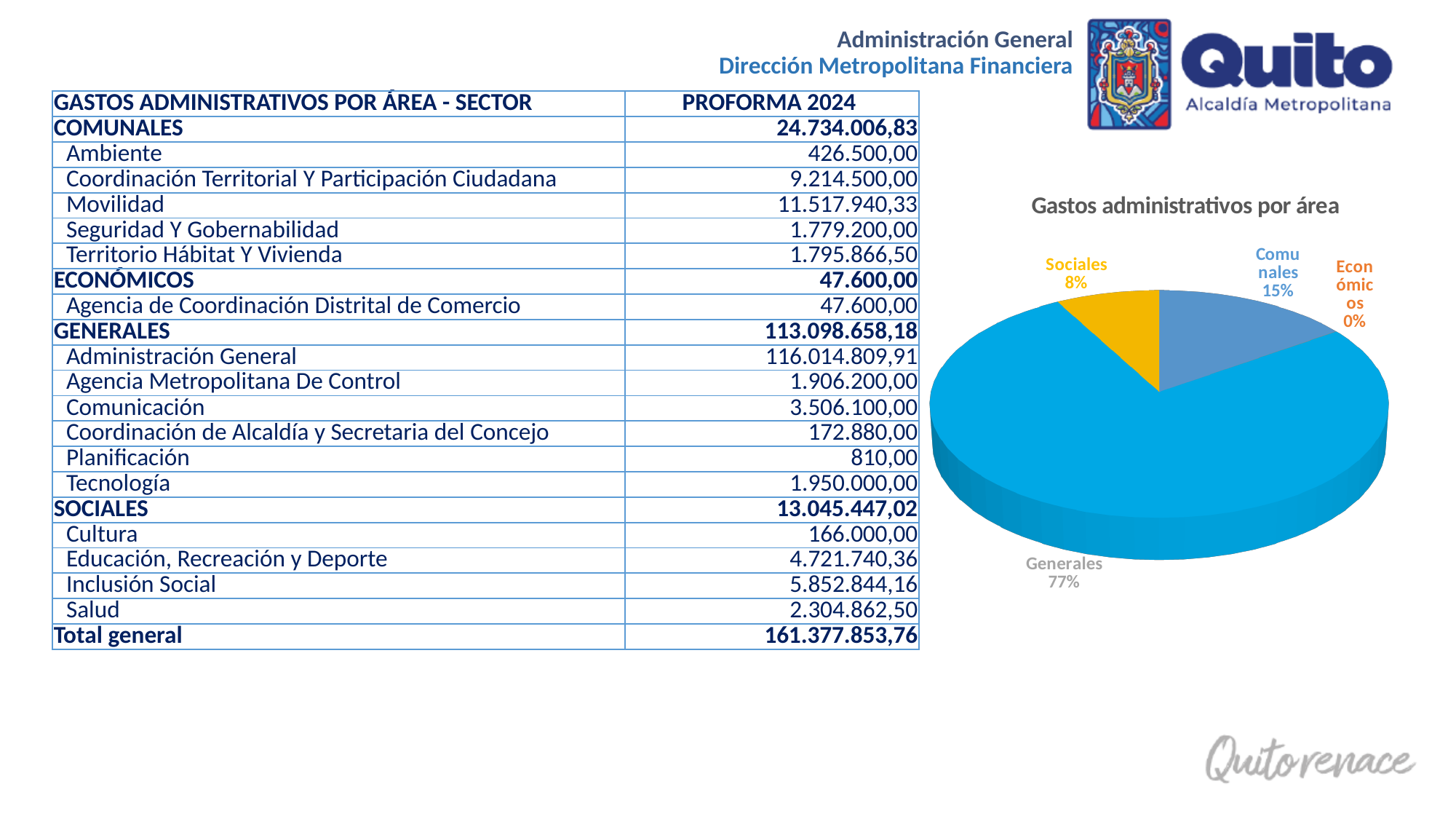
What colour is the Generales slice in the pie chart? blue What kind of chart is shown on the slide? pie chart What share of the pie does Económicos represent? 0% What share of the pie does Generales represent? 77% Which area has the largest slice of the pie chart? Generales What is the difference in percentage points between the Generales and Comunales slices? 62 What is the title of the pie chart? Gastos administrativos por área What share of the pie does Sociales represent? 8% Which area has the smallest slice of the pie chart? Económicos Which slice is larger, Comunales or Sociales? Comunales How many slices does the pie chart have? 4